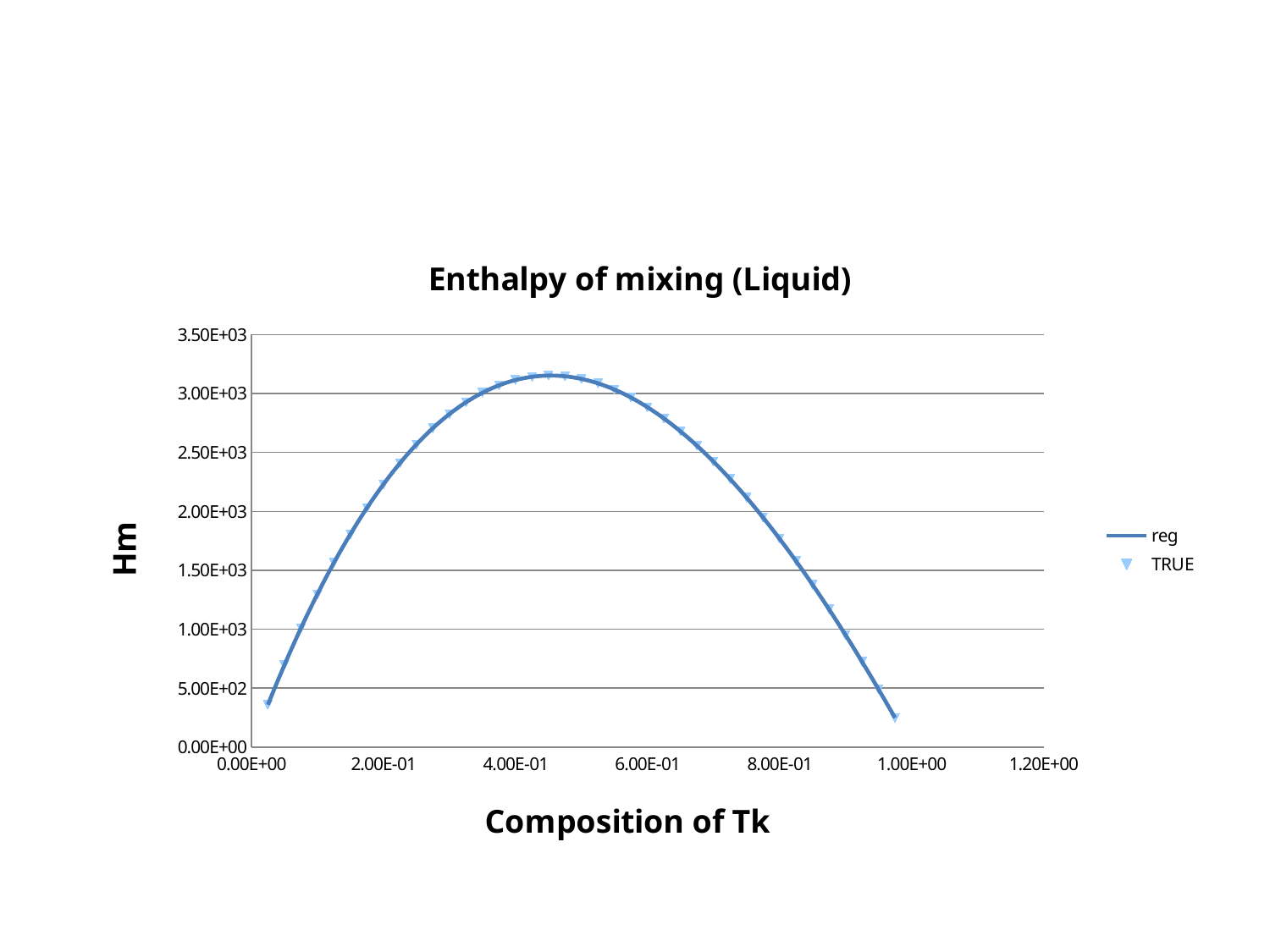
Is the value of the reg curve at a composition of 1.00E+00 greater or less than 5.00E+02? less What is the label of the x axis? Composition of Tk What are the names of the two series in the legend? reg and TRUE Is the peak value of the reg curve greater or less than 3.50E+03? less What is the title of the chart? Enthalpy of mixing (Liquid) Is the value of the reg curve at a composition of 4.00E-01 greater or less than 3.00E+03? greater How does Hm change as the composition of Tk increases from 0 to 1? It rises to a peak and then falls What kind of chart is shown? line chart How many series does the legend list? 2